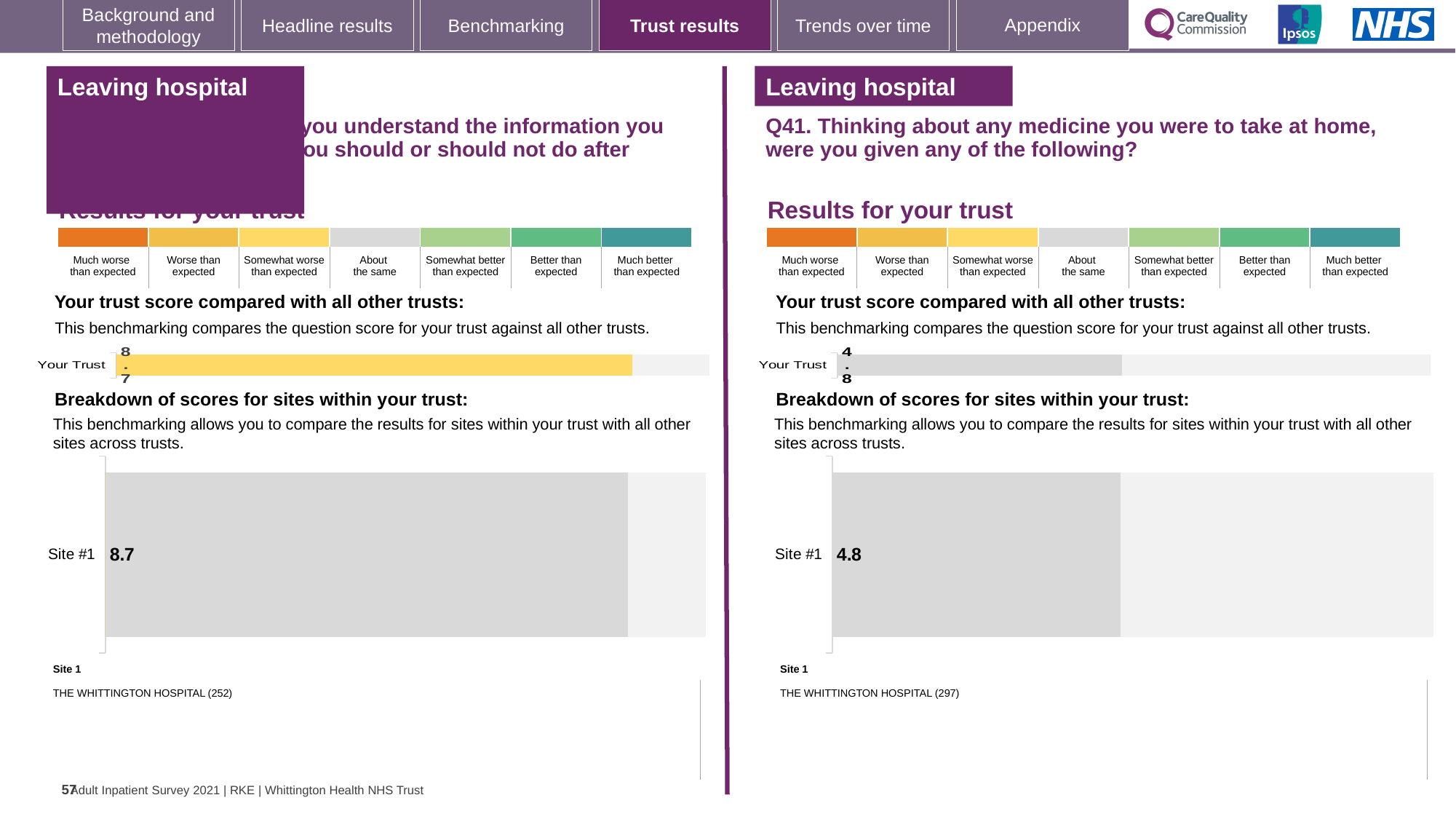
How many sites are listed in the site breakdown chart on the right-hand side for Q41? 1 On the left-hand site breakdown chart, what is the score for Site #1? 8.7 What type of chart is used to show the Your Trust score on the left-hand side? Bar chart What is the difference between the Site #1 score on the left-hand chart and the Site #1 score on the right-hand Q41 chart? 3.9 Which is larger: the Your Trust score on the left-hand chart or the Your Trust score on the right-hand Q41 chart? Left-hand chart (8.7) On the left-hand chart, which benchmark category does the yellow colour of the Your Trust bar correspond to? Somewhat worse than expected Which site is named as Site 1 in the right-hand Q41 site breakdown? THE WHITTINGTON HOSPITAL (297) On the right-hand Q41 chart, which benchmark category does the grey colour of the Your Trust bar correspond to? About the same On the right-hand chart for Q41, what is the score shown for Your Trust? 4.8 How many benchmark categories are shown in the colour key above each chart? 7 On the left-hand chart, what is the score shown for Your Trust? 8.7 On the right-hand site breakdown chart for Q41, what is the score for Site #1? 4.8